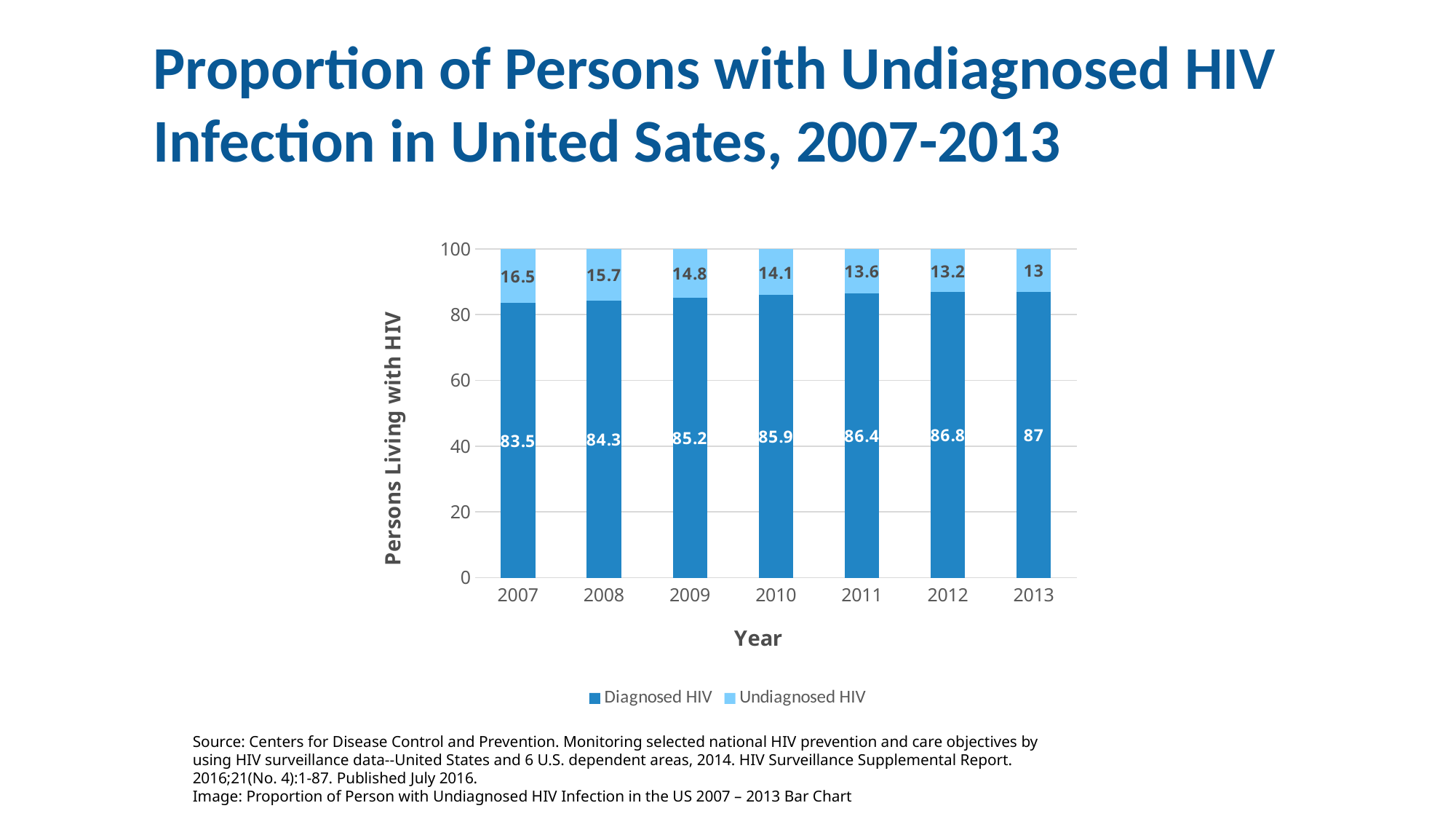
How many years are shown on the x axis? 7 What is the Diagnosed HIV value for 2007? 83.5 What kind of chart is shown on the slide? Stacked bar chart Do the Undiagnosed HIV values rise or fall from 2007 to 2013? Fall What is the Undiagnosed HIV value for 2013? 13 Which year has the lowest Diagnosed HIV value? 2007 Which is larger, the Diagnosed HIV value for 2009 or for 2012? 2012 What is the Undiagnosed HIV value for 2010? 14.1 What is the total of the stacked bar for 2011? 100 Which year has the highest Undiagnosed HIV value? 2007 What is the difference between the Undiagnosed HIV values for 2007 and 2013? 3.5 How many series does the legend list? 2